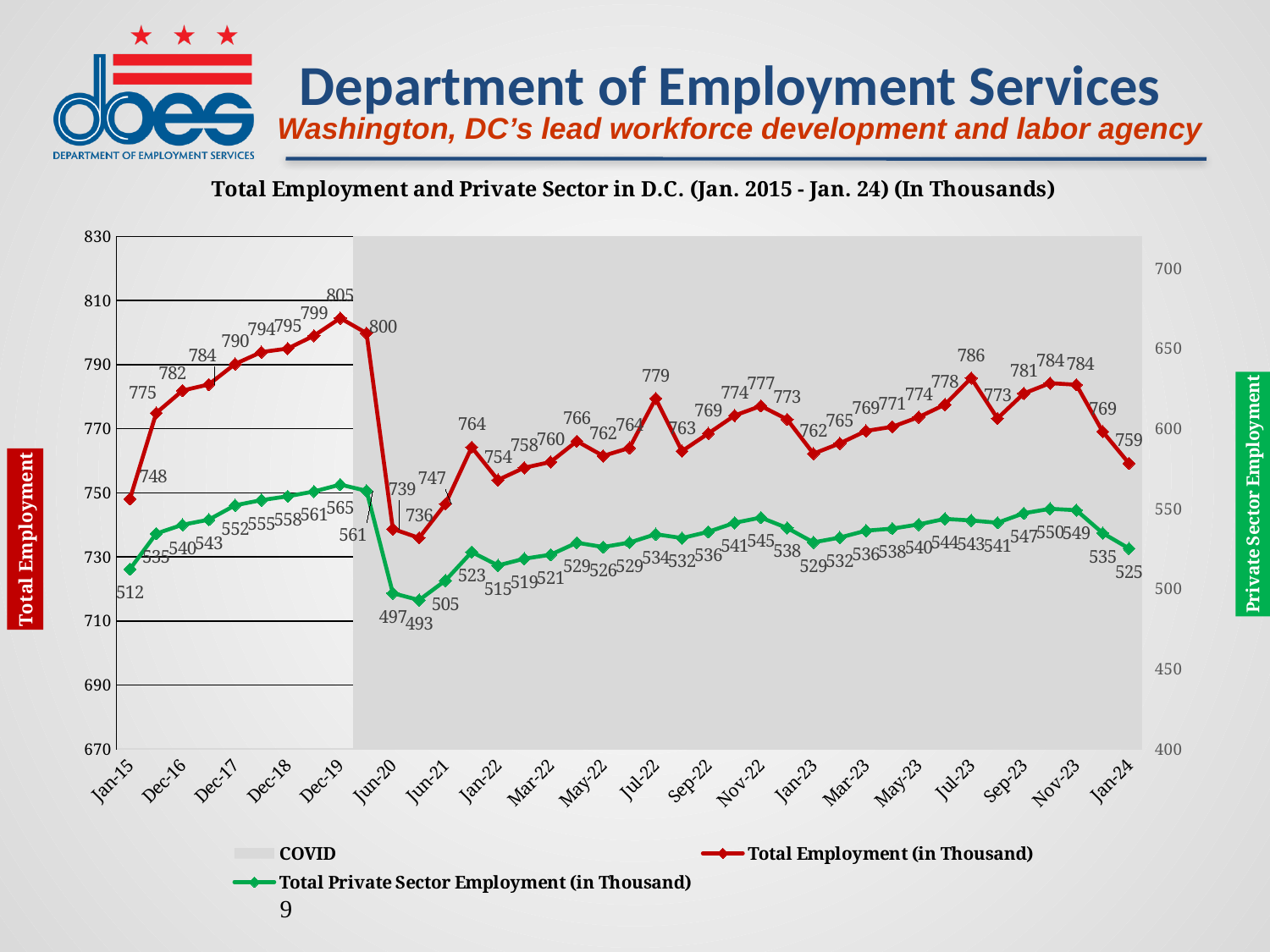
What is the Total Employment value at Jan-24? 759 What is the lowest Total Employment value shown on the chart? 736 What colour is the Total Employment line? red What is the highest Total Private Sector Employment value shown on the chart? 565 By how much does Total Employment at Jan-24 exceed Total Employment at Jan-15? 11 What is the lowest Total Private Sector Employment value shown on the chart? 493 Which is larger: Total Private Sector Employment at Jan-15 or at Jan-24? Jan-24 How many entries does the chart legend list? 3 What is the Total Employment value at Jan-15? 748 What is the Total Private Sector Employment value at Jan-24? 525 What is the highest Total Employment value shown on the chart? 805 What kind of chart is shown on the slide? line chart